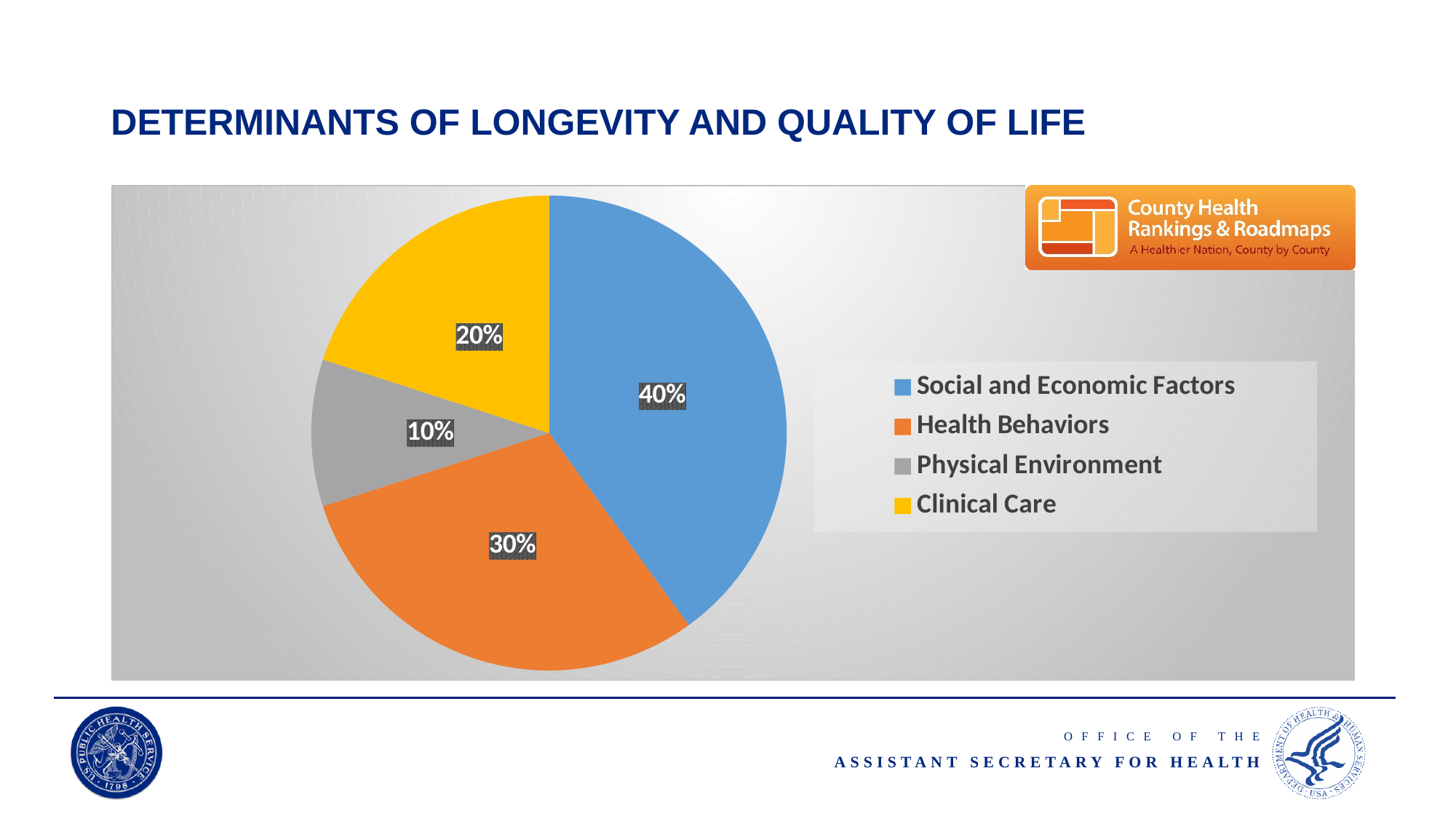
What is the title of the slide containing the pie chart? DETERMINANTS OF LONGEVITY AND QUALITY OF LIFE What share of the pie is Health Behaviors? 30% Which category has the largest slice of the pie? Social and Economic Factors How many categories does the pie chart have? 4 What colour is the Clinical Care slice? Yellow Which category has the smallest slice of the pie? Physical Environment What share of the pie is Physical Environment? 10% Which is larger, the Health Behaviors slice or the Clinical Care slice? Health Behaviors What share of the pie is Clinical Care? 20% What is the difference between the Social and Economic Factors share and the Clinical Care share? 20% What kind of chart is shown on the slide? Pie chart